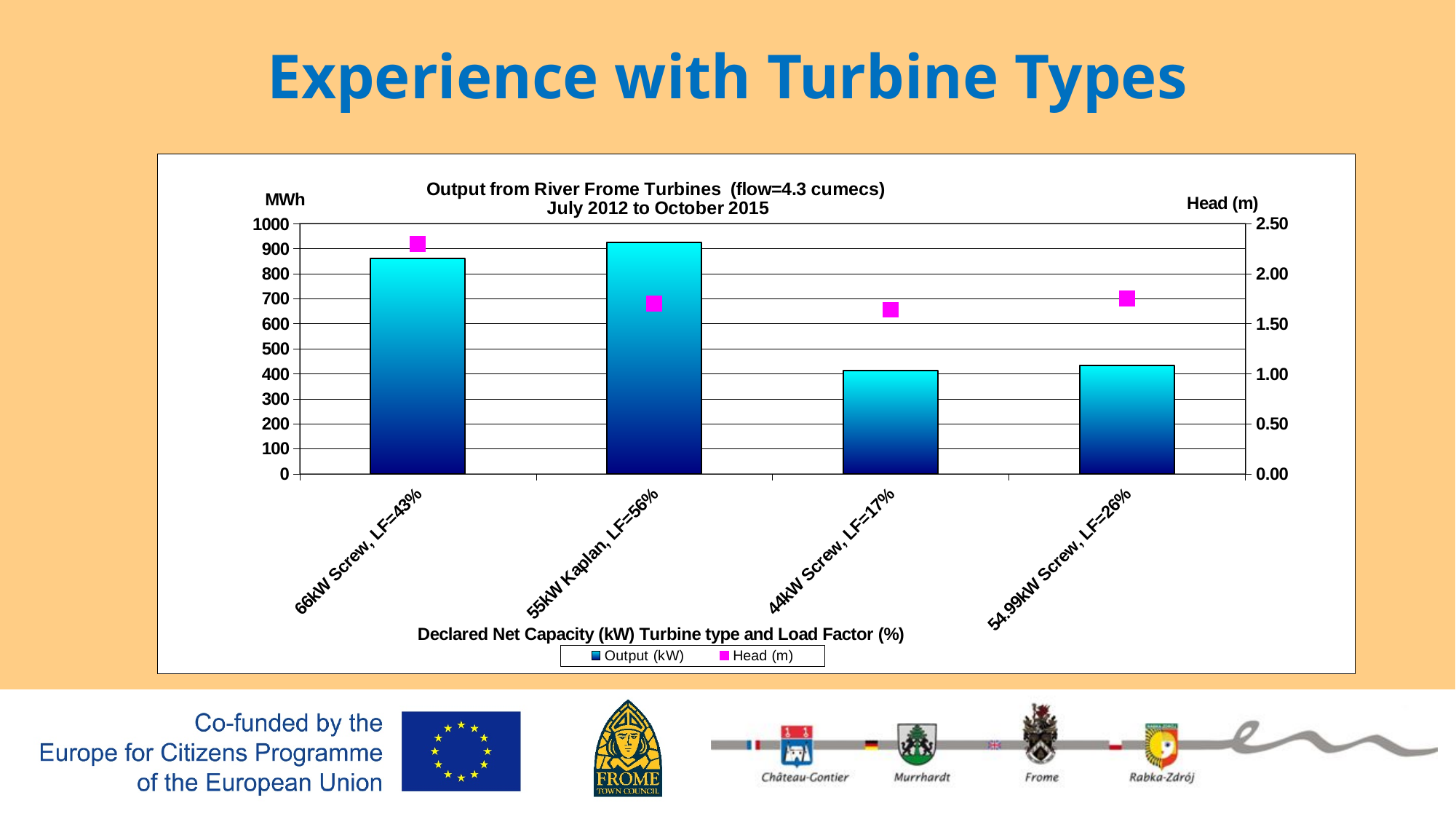
Which turbine has the highest output bar? 55kW Kaplan, LF=56% Which has the larger Head (m) value: 66kW Screw, LF=43% or 55kW Kaplan, LF=56%? 66kW Screw, LF=43% Which has the larger output bar: 66kW Screw, LF=43% or 44kW Screw, LF=17%? 66kW Screw, LF=43% What kind of chart is shown on the slide? bar chart How many turbine categories are shown on the x axis? 4 How many series does the legend list? 2 What is the label of the right-hand vertical axis? Head (m) Is the Head (m) value for 66kW Screw, LF=43% greater or less than 2.00? greater Is the output value for 54.99kW Screw, LF=26% greater or less than 500 MWh? less Which turbine has the highest Head (m) marker? 66kW Screw, LF=43% Is the output value for 44kW Screw, LF=17% greater or less than 500 MWh? less